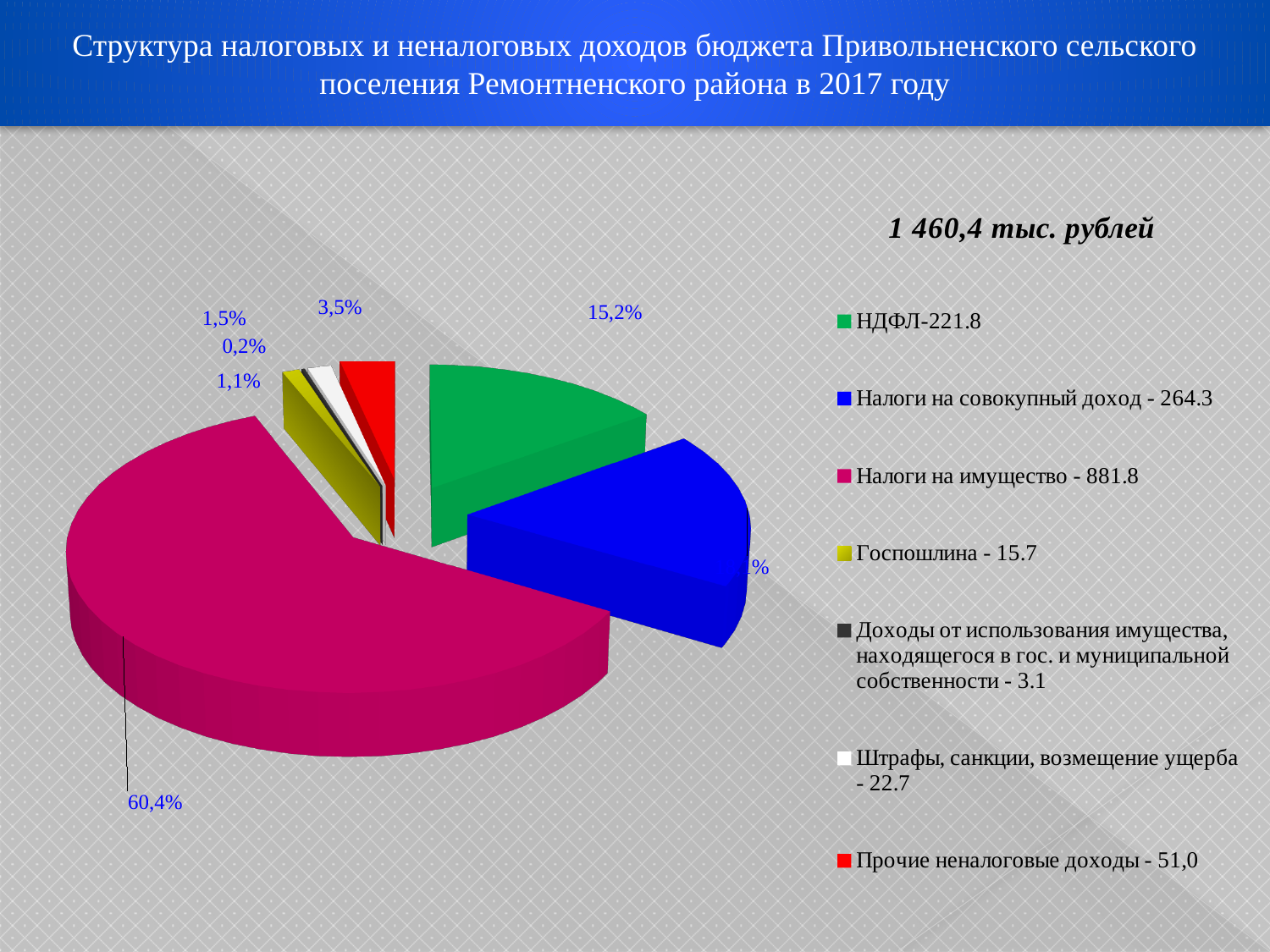
How many categories does the legend of the pie chart list? 7 What value is given in the legend for Госпошлина? 15.7 Which category has the smallest slice of the pie chart? Доходы от использования имущества, находящегося в гос. и муниципальной собственности What value is given in the legend for Налоги на совокупный доход? 264.3 What share of the pie does НДФЛ account for? 15,2% What share of the pie does Налоги на имущество account for? 60,4% Which is larger: Штрафы, санкции, возмещение ущерба or Прочие неналоговые доходы? Прочие неналоговые доходы What value is given in the legend for НДФЛ? 221.8 Which category has the largest slice of the pie chart? Налоги на имущество What kind of chart is shown on the slide? pie chart What is the difference between the values for Налоги на имущество and Налоги на совокупный доход? 617.5 What total amount is stated on the slide for the pie chart? 1 460,4 тыс. рублей